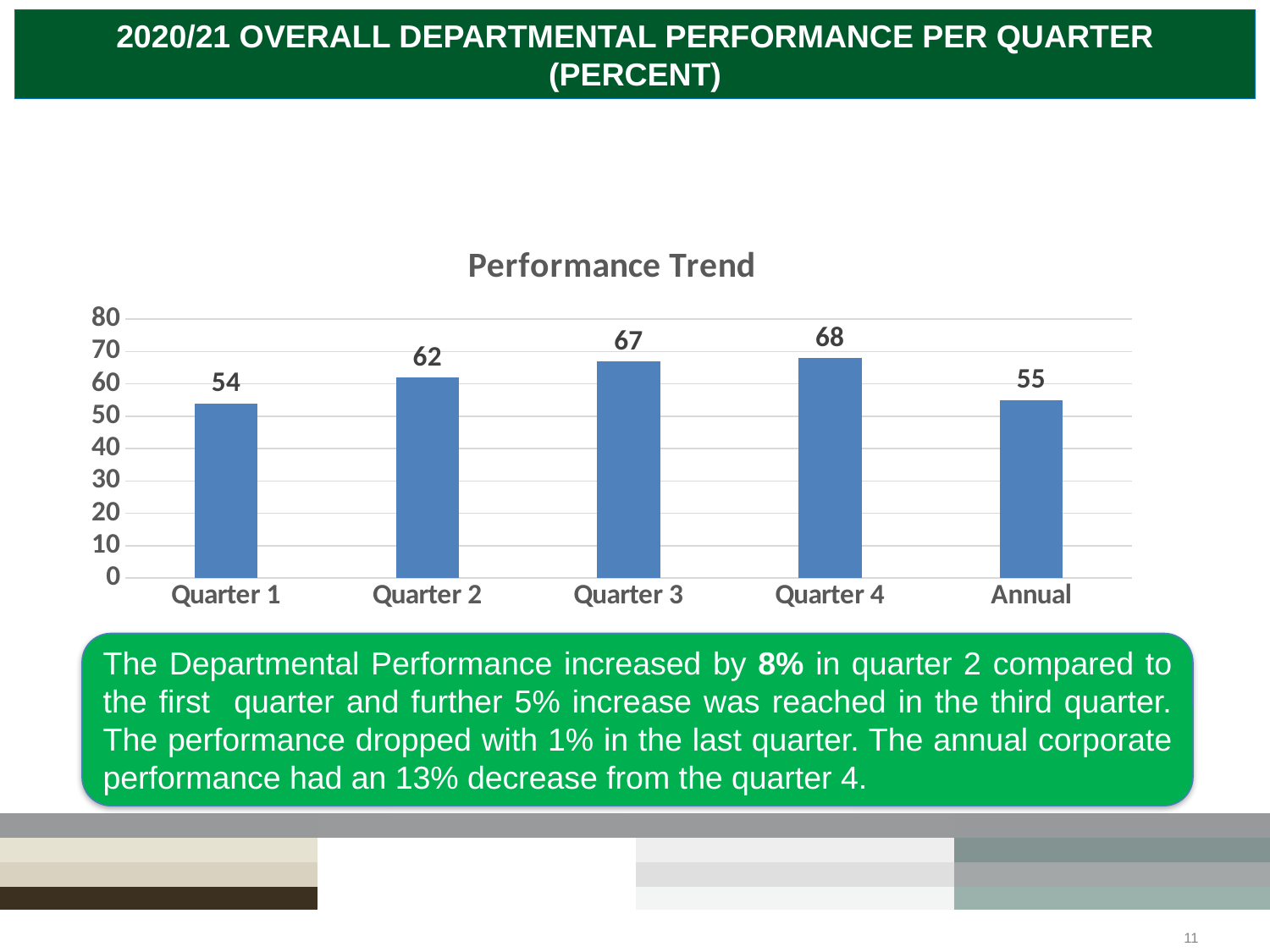
What is the difference between the values for Quarter 2 and Quarter 1? 8 Which is larger, the value for Quarter 2 or the value for Annual? Quarter 2 What is the value for Annual? 55 What is the value for Quarter 3? 67 What is the difference between the values for Quarter 4 and Annual? 13 What is the title of the chart? Performance Trend Which category has the lowest value? Quarter 1 What kind of chart is shown? bar chart Is the value for Quarter 3 greater or less than 60? greater How many categories are shown on the x axis? 5 What is the value for Quarter 1? 54 Which category has the highest value? Quarter 4